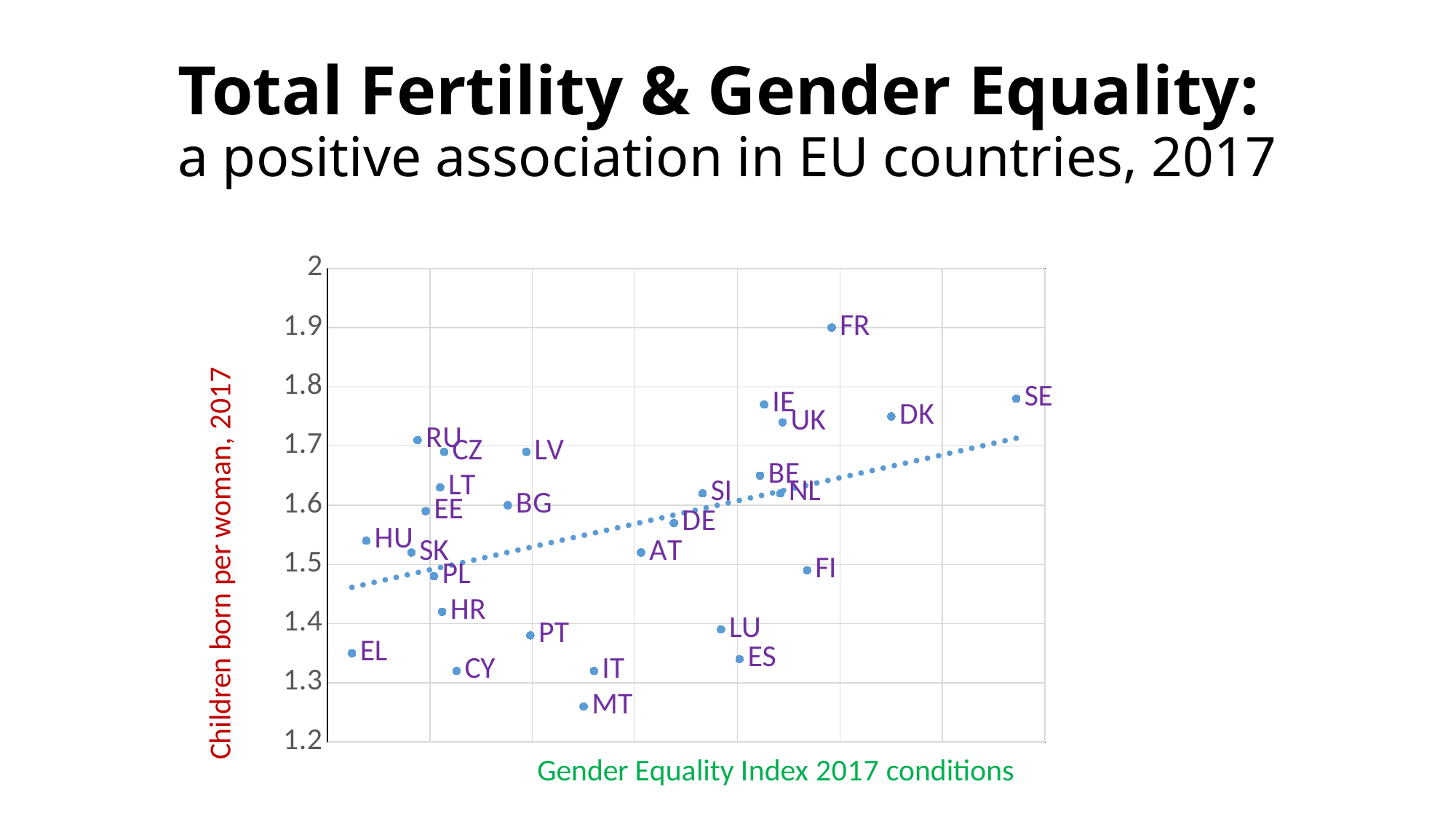
What kind of chart is shown on the slide? Scatter plot Is the value for EL greater or less than 1.4 children per woman? less How many countries are plotted in the chart? 28 Does the dotted trend line rise or fall as the Gender Equality Index increases? Rises Which has more children born per woman, FR or SE? FR Which country has the lowest number of children born per woman in the chart? MT Which has fewer children born per woman, MT or IT? MT Is the value for SE greater or less than 1.7 children per woman? greater Is the value for HU greater or less than 1.5 children per woman? greater What is the label on the vertical axis of the chart? Children born per woman, 2017 Which country has the highest number of children born per woman in the chart? FR